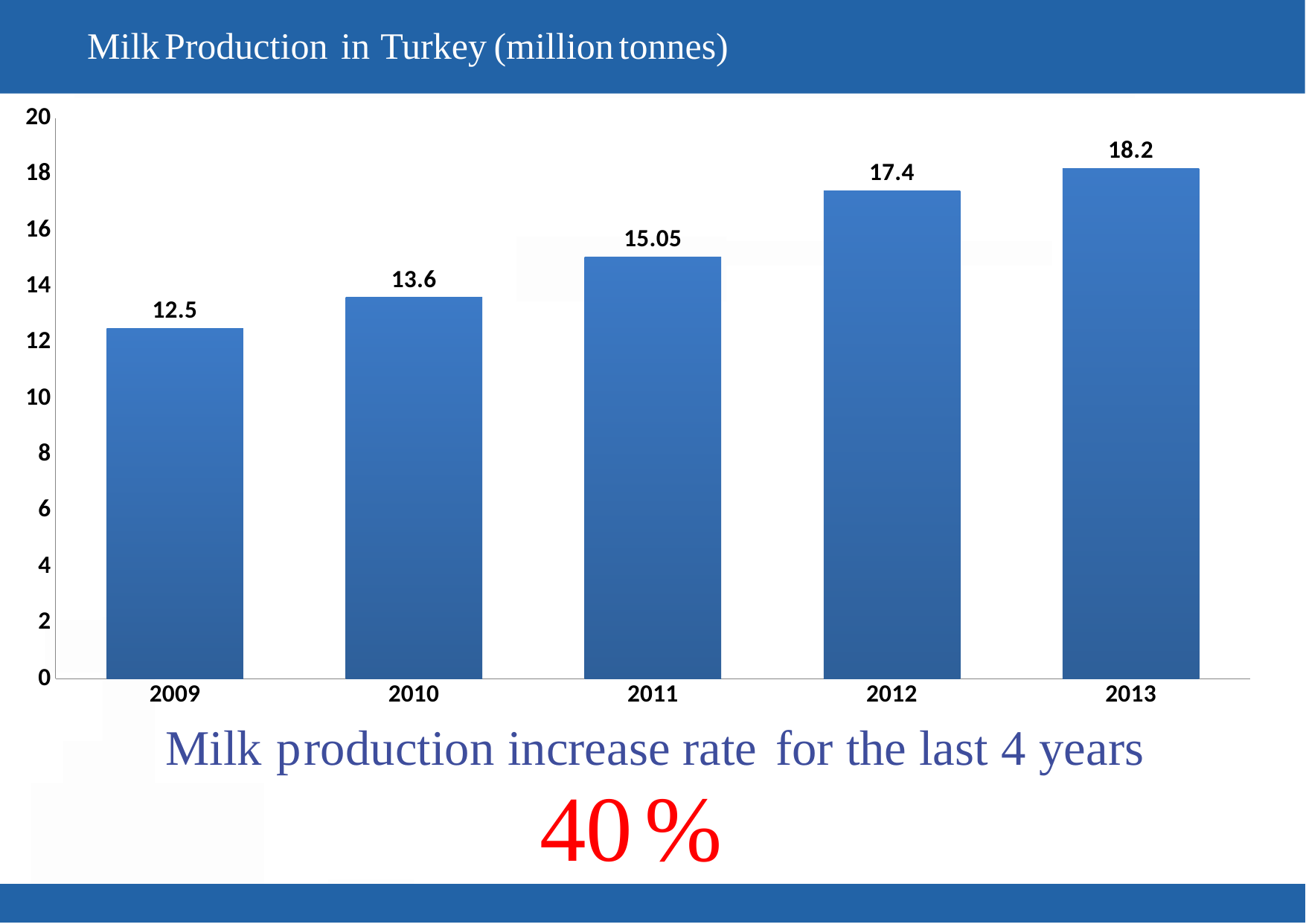
Which year had the lowest milk production? 2009 Which year had higher milk production, 2010 or 2012? 2012 Does milk production rise or fall from 2009 to 2013? rise Which year had the highest milk production? 2013 How many years are shown on the chart? 5 What is the difference in milk production between 2013 and 2009? 5.7 What was milk production in Turkey in 2009? 12.5 What was milk production in Turkey in 2013? 18.2 What kind of chart is shown on the slide? bar chart What was milk production in Turkey in 2011? 15.05 Is the value for 2010 greater or less than 14? less What is the difference in milk production between 2012 and 2011? 2.35